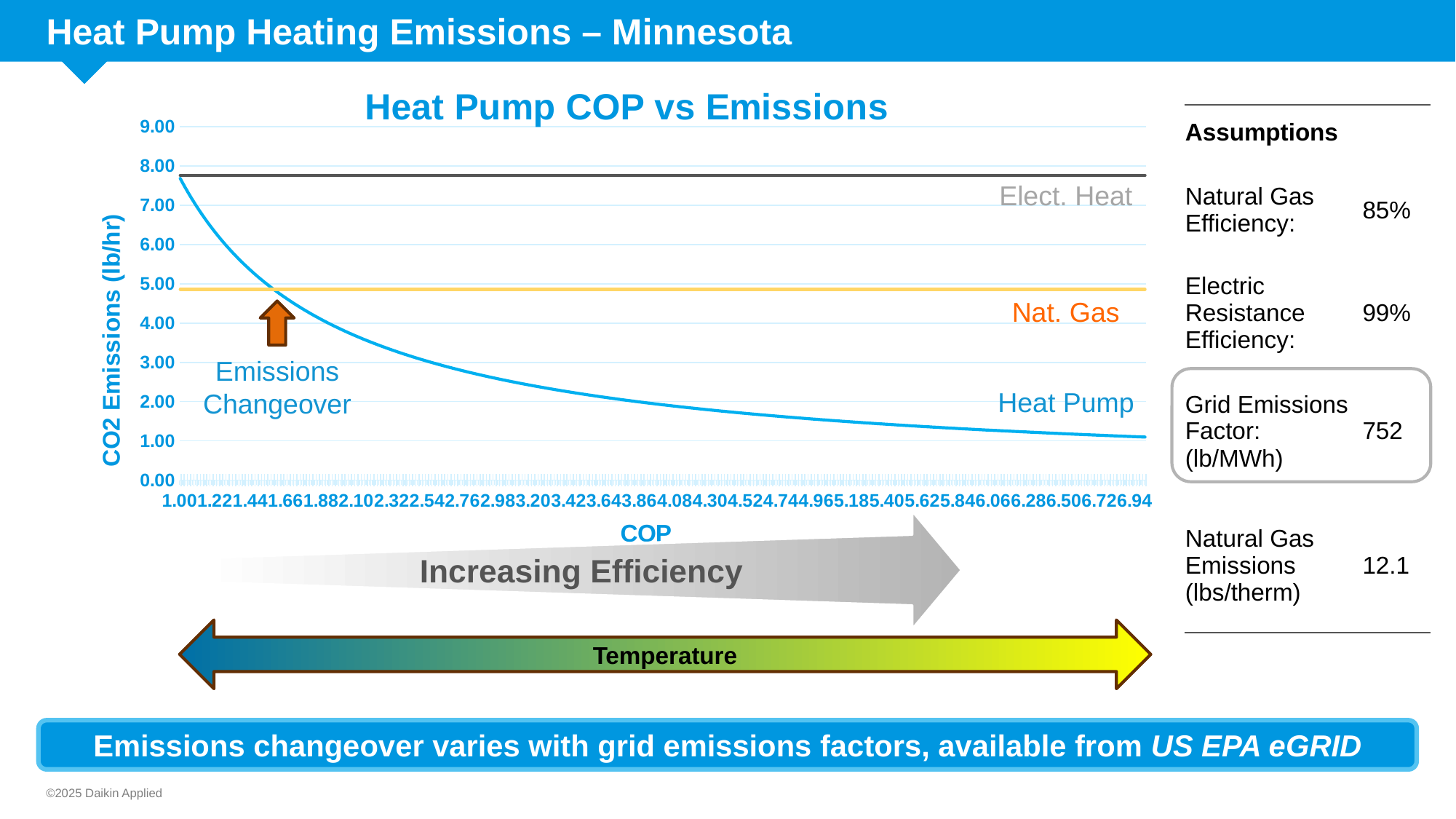
Is the Heat Pump value at a COP of 6.94 greater or less than 2.00? less How many series are plotted on the chart? 3 Which is larger, the Elect. Heat emissions or the Nat. Gas emissions? Elect. Heat Is the value for Elect. Heat greater or less than 7.00? greater At a COP of 3.00, which is larger, the Heat Pump emissions or the Nat. Gas emissions? Nat. Gas What is the label of the vertical axis of the chart? CO2 Emissions (lb/hr) Which series has the lowest emissions at a COP of 6.94? Heat Pump What type of chart is shown on the slide? line chart Does the Heat Pump line rise or fall as COP increases along the x axis? fall What is the title of the chart? Heat Pump COP vs Emissions Which series has the highest emissions on the chart? Elect. Heat Is the value for Nat. Gas greater or less than 5.00? less